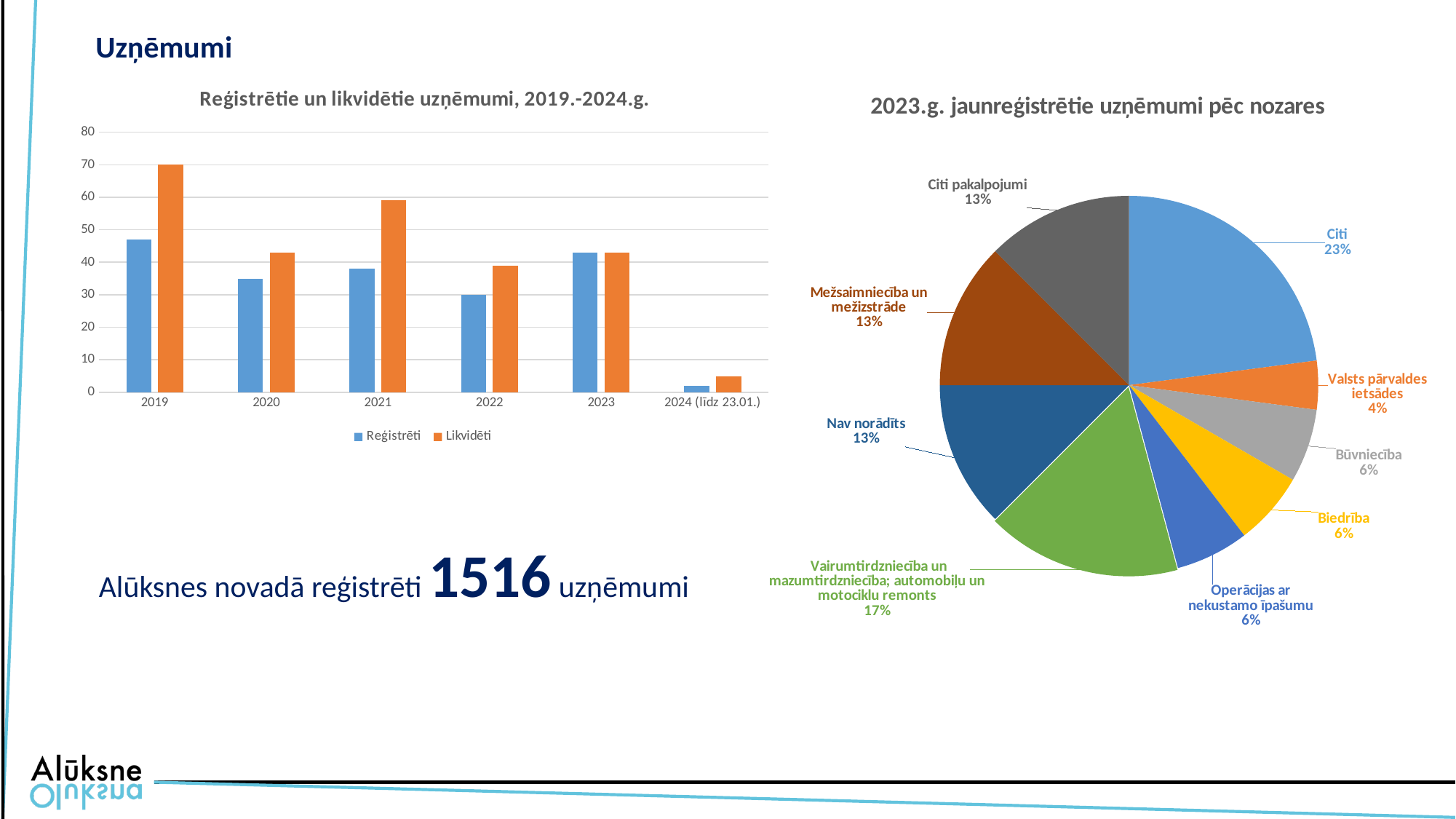
In the chart 'Reģistrētie un likvidētie uzņēmumi, 2019.-2024.g.', is the Likvidēti value for 2019 greater or less than 60? greater In the chart 'Reģistrētie un likvidētie uzņēmumi, 2019.-2024.g.', how many series does the legend list? 2 In the chart '2023.g. jaunreģistrētie uzņēmumi pēc nozares', what is the difference between the share of 'Citi' and the share of 'Vairumtirdzniecība un mazumtirdzniecība; automobiļu un motociklu remonts'? 6% In the chart '2023.g. jaunreģistrētie uzņēmumi pēc nozares', how many slices does the pie have? 9 In the chart 'Reģistrētie un likvidētie uzņēmumi, 2019.-2024.g.', which year has the highest Likvidēti value? 2019 In the chart '2023.g. jaunreģistrētie uzņēmumi pēc nozares', what is the share for 'Valsts pārvaldes iestādes'? 4% In the chart '2023.g. jaunreģistrētie uzņēmumi pēc nozares', what share does 'Citi' have? 23% In the chart 'Reģistrētie un likvidētie uzņēmumi, 2019.-2024.g.', is the Reģistrēti value for 2022 greater or less than 40? less In the chart 'Reģistrētie un likvidētie uzņēmumi, 2019.-2024.g.', which category has the lowest Reģistrēti value? 2024 (līdz 23.01.) In the chart 'Reģistrētie un likvidētie uzņēmumi, 2019.-2024.g.', how many year categories are shown on the x axis? 6 In the chart 'Reģistrētie un likvidētie uzņēmumi, 2019.-2024.g.', what kind of chart is shown? bar chart In the chart 'Reģistrētie un likvidētie uzņēmumi, 2019.-2024.g.', which is larger for 2021: Reģistrēti or Likvidēti? Likvidēti